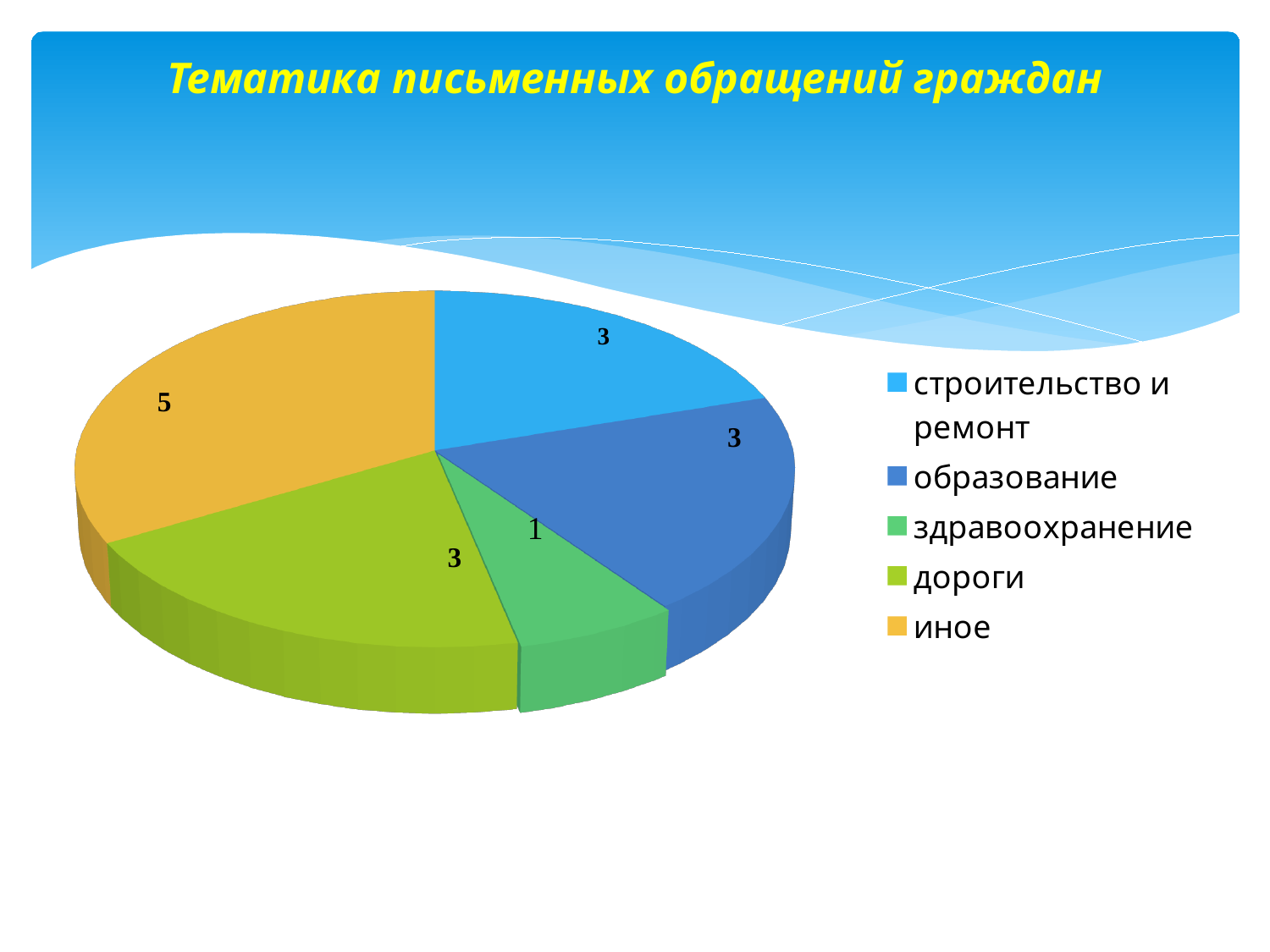
What is the value for дороги? 3 What is the title of the chart? Тематика письменных обращений граждан What is the value for здравоохранение? 1 How many categories does the pie chart have? 5 What is the value for иное? 5 What share of the pie does иное represent? 1/3 Which category has the largest slice? иное Which is larger, the value for иное or the value for строительство и ремонт? иное Which category has the smallest slice? здравоохранение What kind of chart is shown on the slide? pie chart What is the value for образование? 3 What is the difference between the values for иное and здравоохранение? 4